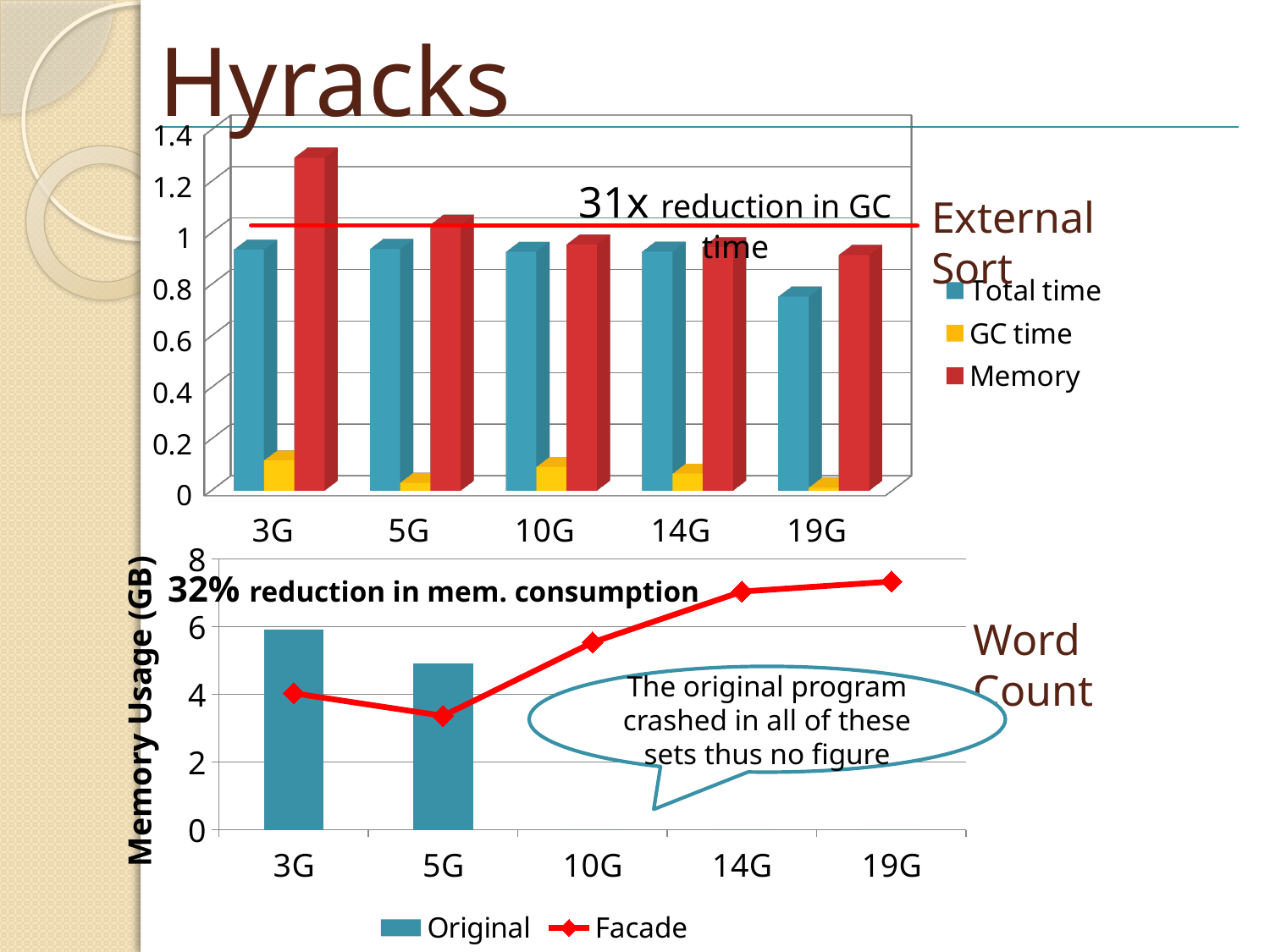
In the Word Count chart, does the Facade line rise or fall from 5G to 19G? rise In the Word Count chart, is the Facade value for 19G greater or less than 6? greater In the External Sort chart, which data size has the lowest Total time? 19G In the External Sort chart, is the Memory value for 3G greater or less than 1.2? greater In the External Sort chart, which data size has the highest Memory value? 3G In the External Sort chart, how many data sizes are shown on the x axis? 5 In the Word Count chart, how many series does the legend list? 2 In the External Sort chart, is the Total time value for 19G greater or less than 0.8? less In the Word Count chart, which data size has the lowest Facade value? 5G In the External Sort chart, how many series does the legend list? 3 In the Word Count chart, which is larger, the Original value for 3G or the Original value for 5G? 3G